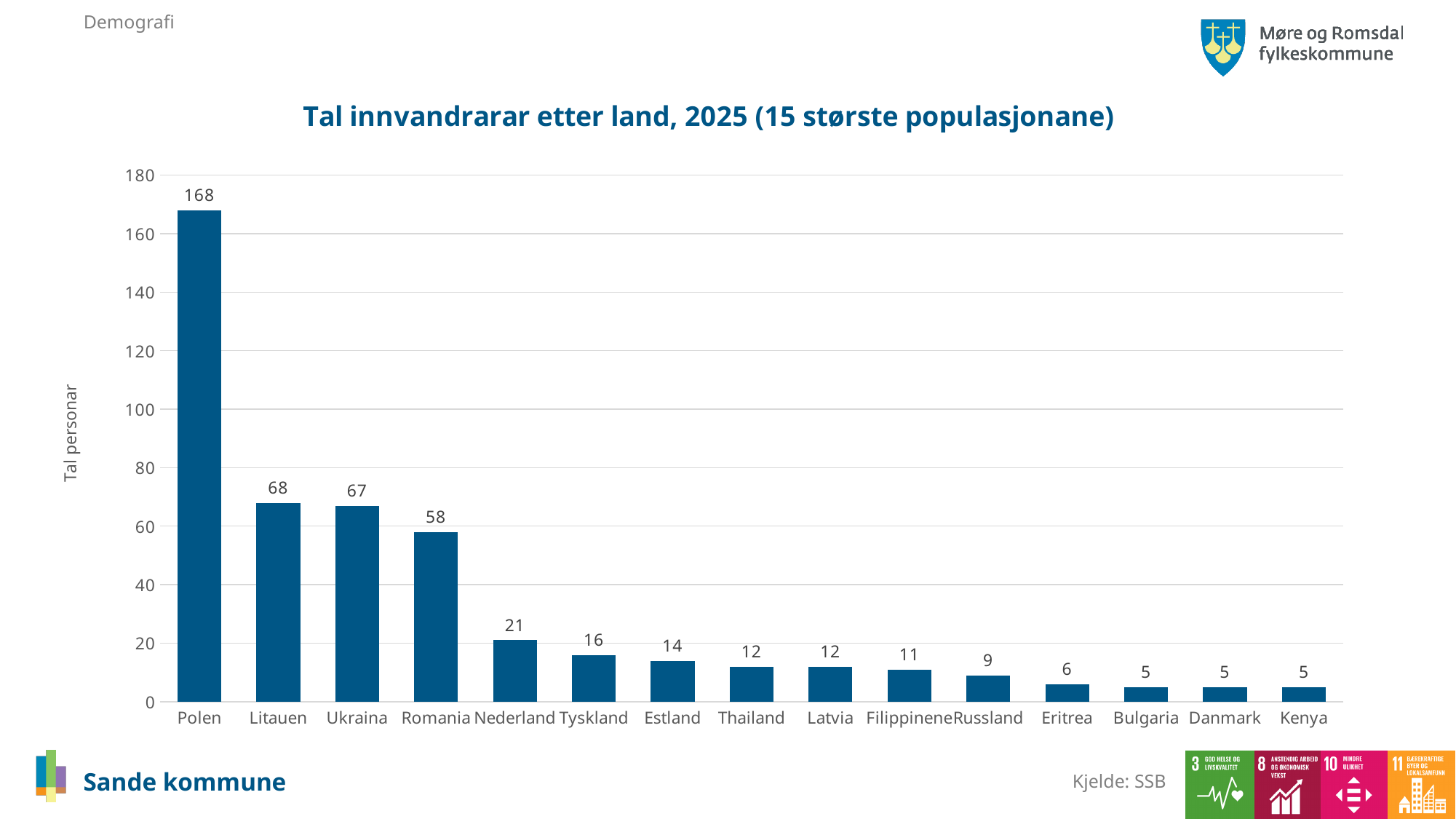
Which country has the highest value? Polen What is the value for Nederland? 21 What is the value for Romania? 58 What is the difference between the values for Tyskland and Estland? 2 How many countries are shown on the x axis? 15 Do the values rise or fall from left to right along the x axis? fall What kind of chart is this? bar chart What is the difference between the values for Polen and Litauen? 100 Which is larger, the value for Ukraina or the value for Romania? Ukraina Is the value for Polen greater or less than 160? greater What is the value for Polen? 168 What is the title of the chart? Tal innvandrarar etter land, 2025 (15 største populasjonane)